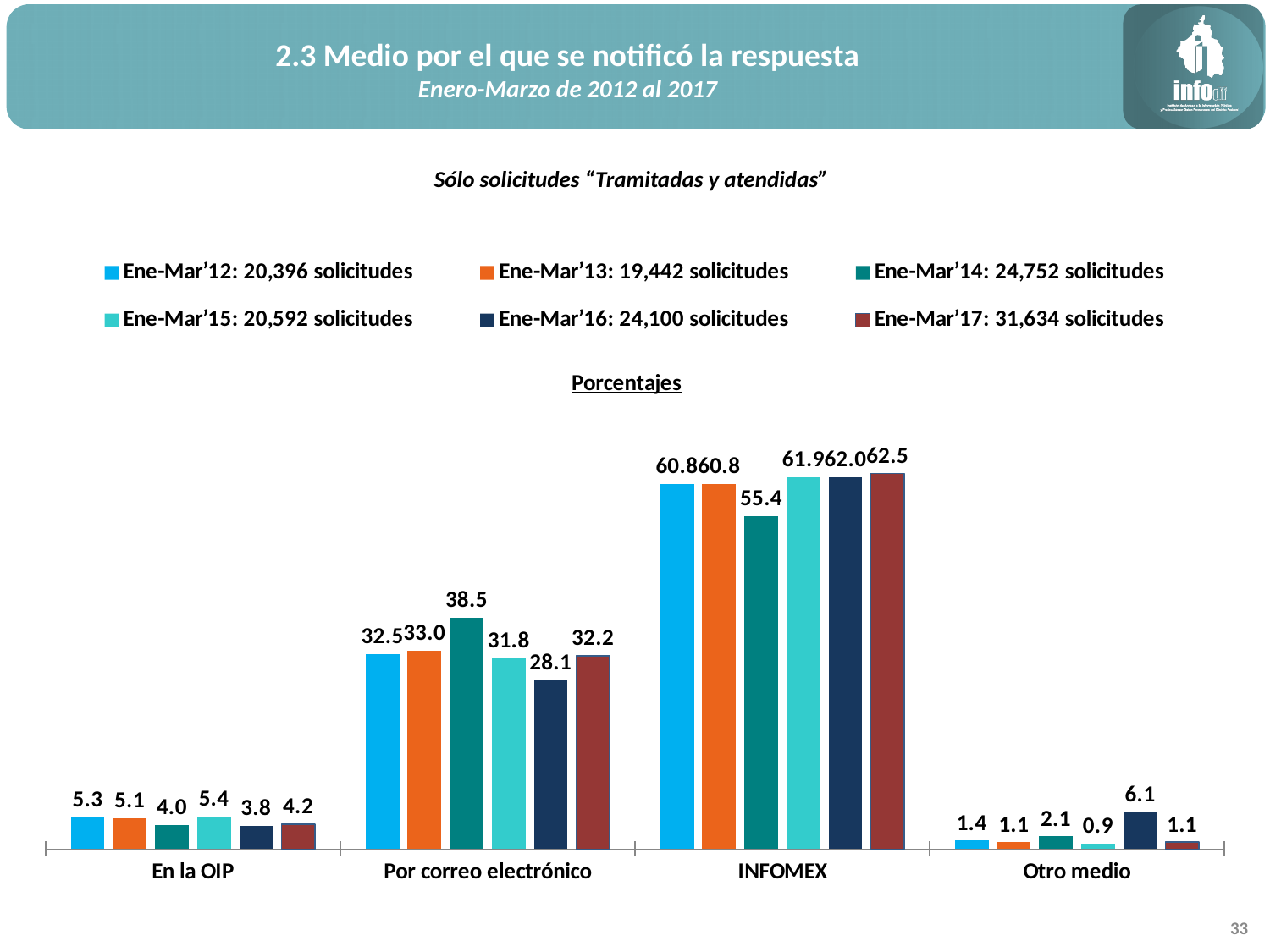
Which series has the highest value in the Por correo electrónico category? Ene-Mar'14 What is the value for Ene-Mar'17 in the INFOMEX category? 62.5 How many solicitudes does the legend give for Ene-Mar'17? 31,634 What kind of chart is shown on the slide? bar chart Which is larger in the En la OIP category: the Ene-Mar'15 value or the Ene-Mar'16 value? Ene-Mar'15 What is the value for Ene-Mar'16 in the Otro medio category? 6.1 Which series has the lowest value in the INFOMEX category? Ene-Mar'14 What is the value for Ene-Mar'14 in the Por correo electrónico category? 38.5 What is the difference between the Ene-Mar'17 and Ene-Mar'14 values in the INFOMEX category? 7.1 How many series does the legend list? 6 How many categories are shown on the x axis? 4 What is the difference between the Ene-Mar'14 and Ene-Mar'16 values in the Por correo electrónico category? 10.4